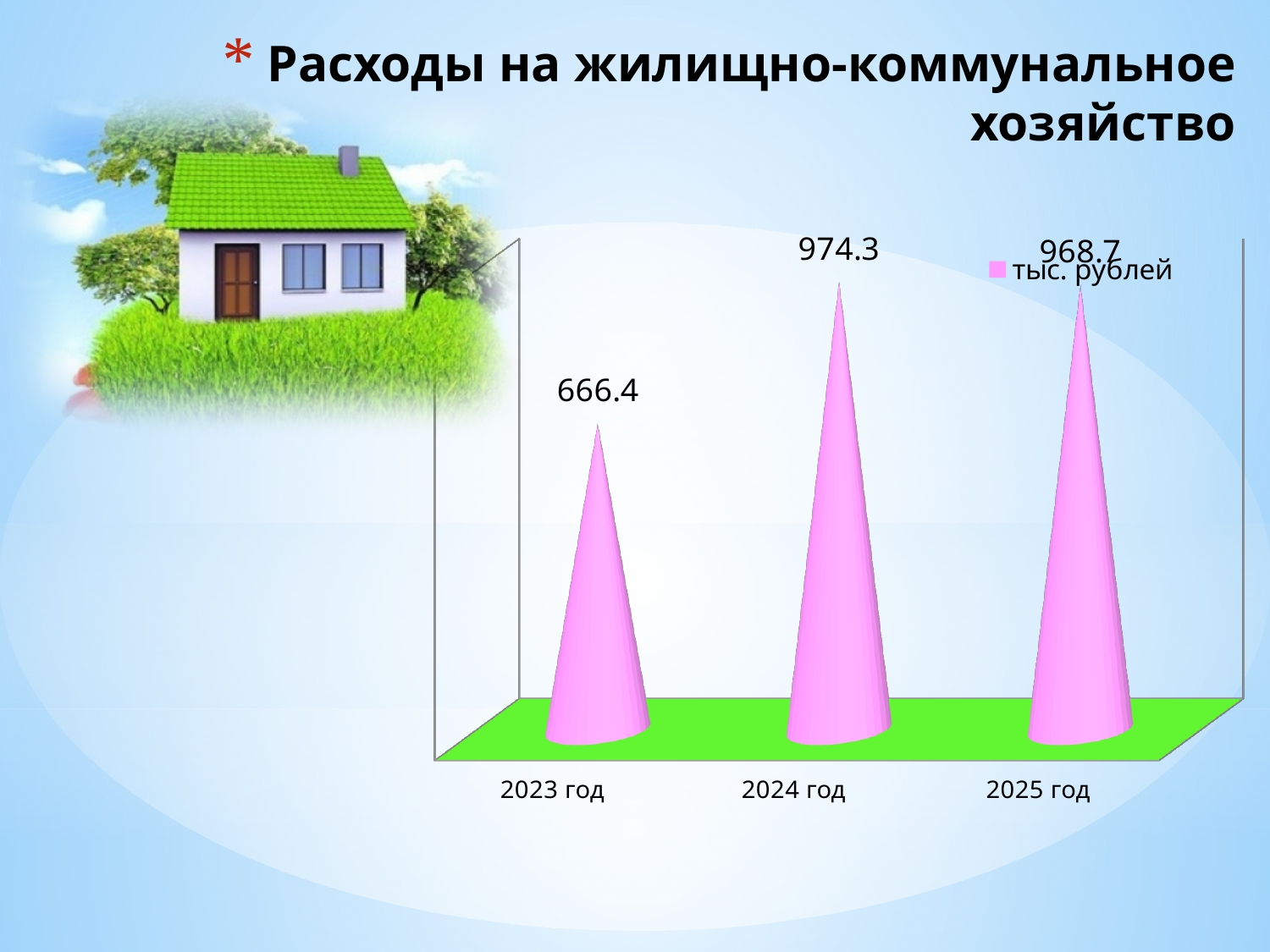
What is the value for 2024 год? 974.3 How many categories are shown on the x axis? 3 What kind of chart is shown on the slide? bar chart What is the legend entry of the chart? тыс. рублей Which is larger, the value for 2025 год or the value for 2023 год? 2025 год How many series does the legend list? 1 What is the value for 2023 год? 666.4 What is the difference between the values for 2024 год and 2025 год? 5.6 Which year has the lowest value? 2023 год Which year has the highest value? 2024 год What is the value for 2025 год? 968.7 What is the difference between the values for 2024 год and 2023 год? 307.9